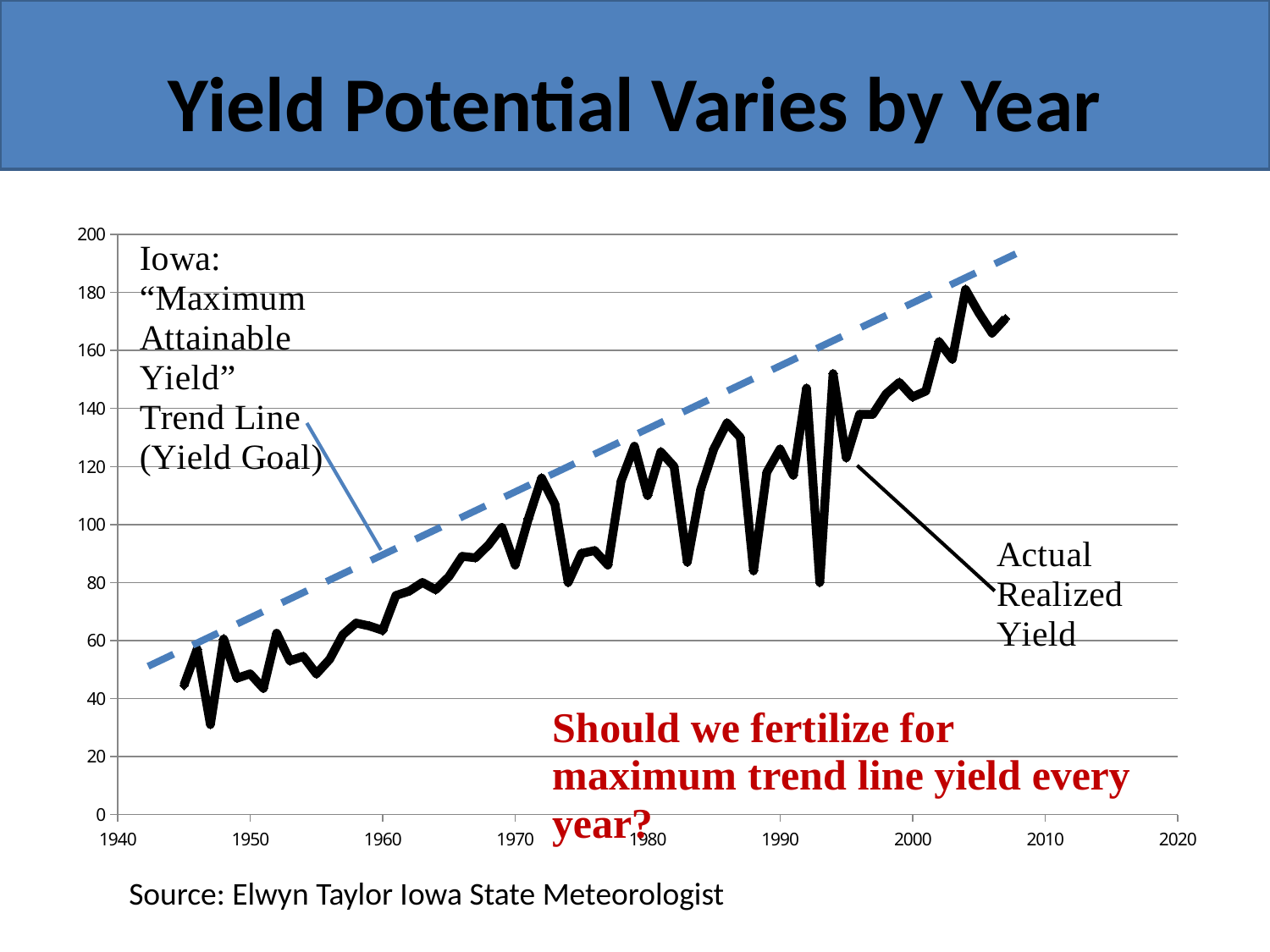
Is the dashed trend line value at its left end in the early 1940s greater or less than 40? greater What kind of chart is shown on the slide? line chart Does the dashed Maximum Attainable Yield trend line rise or fall from left to right? rise Does the Actual Realized Yield line generally rise or fall from the 1940s to the 2000s? rise What does the dashed line on the chart represent? "Maximum Attainable Yield" Trend Line (Yield Goal) Is the dashed trend line value at its right end near 2010 greater or less than 180? greater Is the Actual Realized Yield value around 1972 greater or less than 100? greater What is the title of the slide? Yield Potential Varies by Year